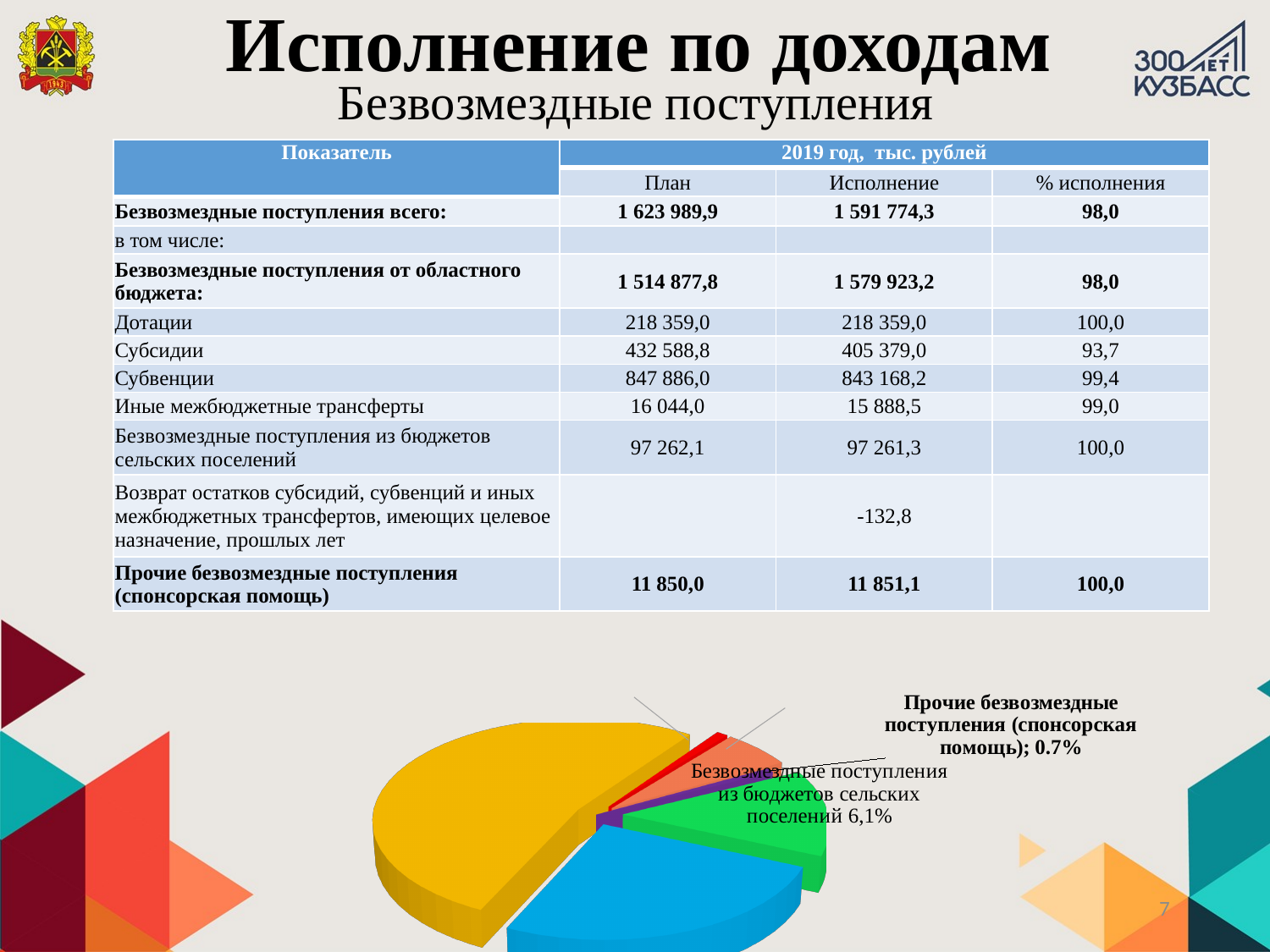
In the pie chart, what share is labelled for "Прочие безвозмездные поступления (спонсорская помощь)"? 0.7% How many slices does the pie chart contain? 6 In the pie chart, which labelled slice is larger: "Безвозмездные поступления из бюджетов сельских поселений" or "Прочие безвозмездные поступления (спонсорская помощь)"? Безвозмездные поступления из бюджетов сельских поселений What kind of chart is shown at the bottom of the slide? Pie chart How many slices of the pie chart have a data label with a percentage printed on the slide? 2 In the pie chart, which of the two labelled slices has the smaller share? Прочие безвозмездные поступления (спонсорская помощь) In the pie chart, what share is labelled for "Безвозмездные поступления из бюджетов сельских поселений"? 6,1% What colour is the largest slice of the pie chart? Yellow